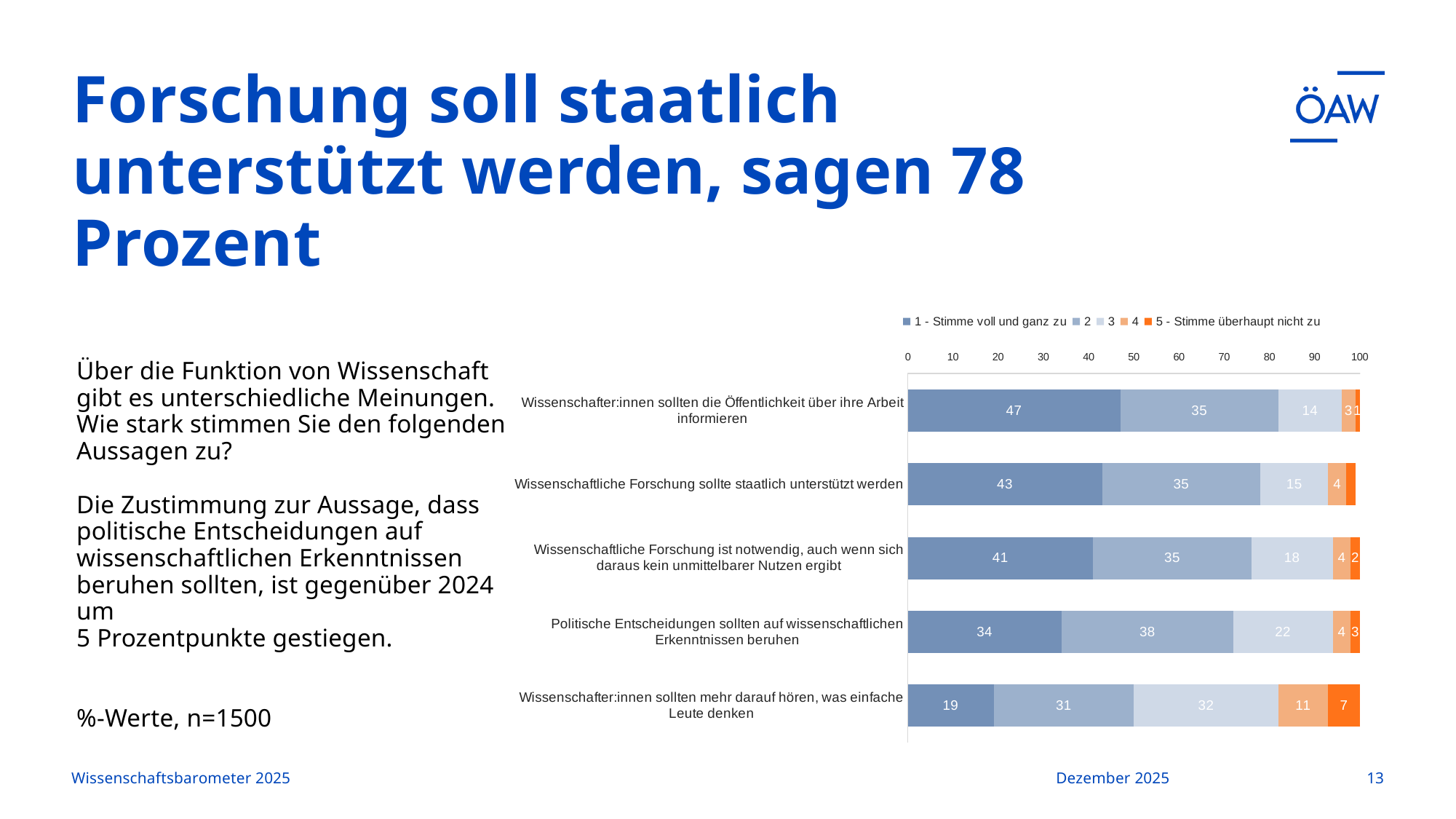
Which statement has the lowest value for '1 - Stimme voll und ganz zu'? Wissenschafter:innen sollten mehr darauf hören, was einfache Leute denken How many statements (categories) are shown in the chart? 5 What is the value of '2' for 'Politische Entscheidungen sollten auf wissenschaftlichen Erkenntnissen beruhen'? 38 Which is larger: the '5 - Stimme überhaupt nicht zu' value for 'Wissenschafter:innen sollten mehr darauf hören, was einfache Leute denken' or for 'Wissenschaftliche Forschung ist notwendig, auch wenn sich daraus kein unmittelbarer Nutzen ergibt'? Wissenschafter:innen sollten mehr darauf hören, was einfache Leute denken Which statement has the highest value for '1 - Stimme voll und ganz zu'? Wissenschafter:innen sollten die Öffentlichkeit über ihre Arbeit informieren What is the value of '1 - Stimme voll und ganz zu' for 'Wissenschaftliche Forschung sollte staatlich unterstützt werden'? 43 How many series does the chart legend list? 5 What kind of chart is shown on the slide? Stacked bar chart What is the value of '3' for 'Wissenschafter:innen sollten mehr darauf hören, was einfache Leute denken'? 32 What is the label of the first legend entry in the chart? 1 - Stimme voll und ganz zu What is the total of the stacked bar for 'Wissenschafter:innen sollten mehr darauf hören, was einfache Leute denken'? 100 What is the difference between the '1 - Stimme voll und ganz zu' values for 'Wissenschafter:innen sollten die Öffentlichkeit über ihre Arbeit informieren' and 'Politische Entscheidungen sollten auf wissenschaftlichen Erkenntnissen beruhen'? 13